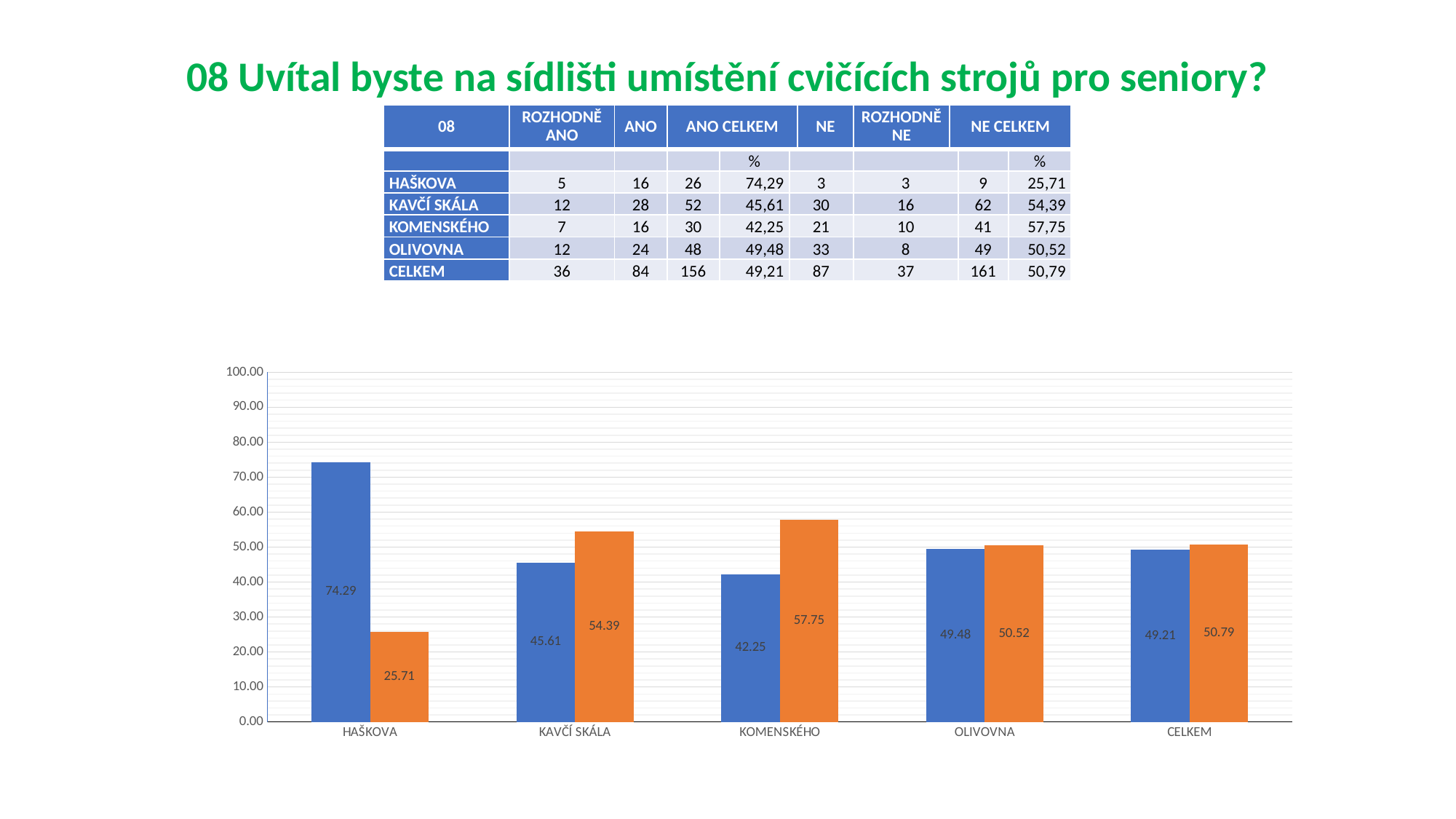
Which category has the lowest orange bar? HAŠKOVA What is the difference between the blue and orange bars for HAŠKOVA? 48.58 What is the value of the blue bar for OLIVOVNA? 49.48 How many categories are shown on the x axis of the chart? 5 What is the value of the orange bar for CELKEM? 50.79 For KAVČÍ SKÁLA, which is larger, the blue bar or the orange bar? the orange bar Which category has the highest blue bar? HAŠKOVA What kind of chart is shown on the slide? bar chart What is the value of the blue bar for HAŠKOVA? 74.29 Which category has the lowest blue bar? KOMENSKÉHO What is the value of the orange bar for KOMENSKÉHO? 57.75 Is the value of the orange bar for KOMENSKÉHO greater or less than 50.00? greater